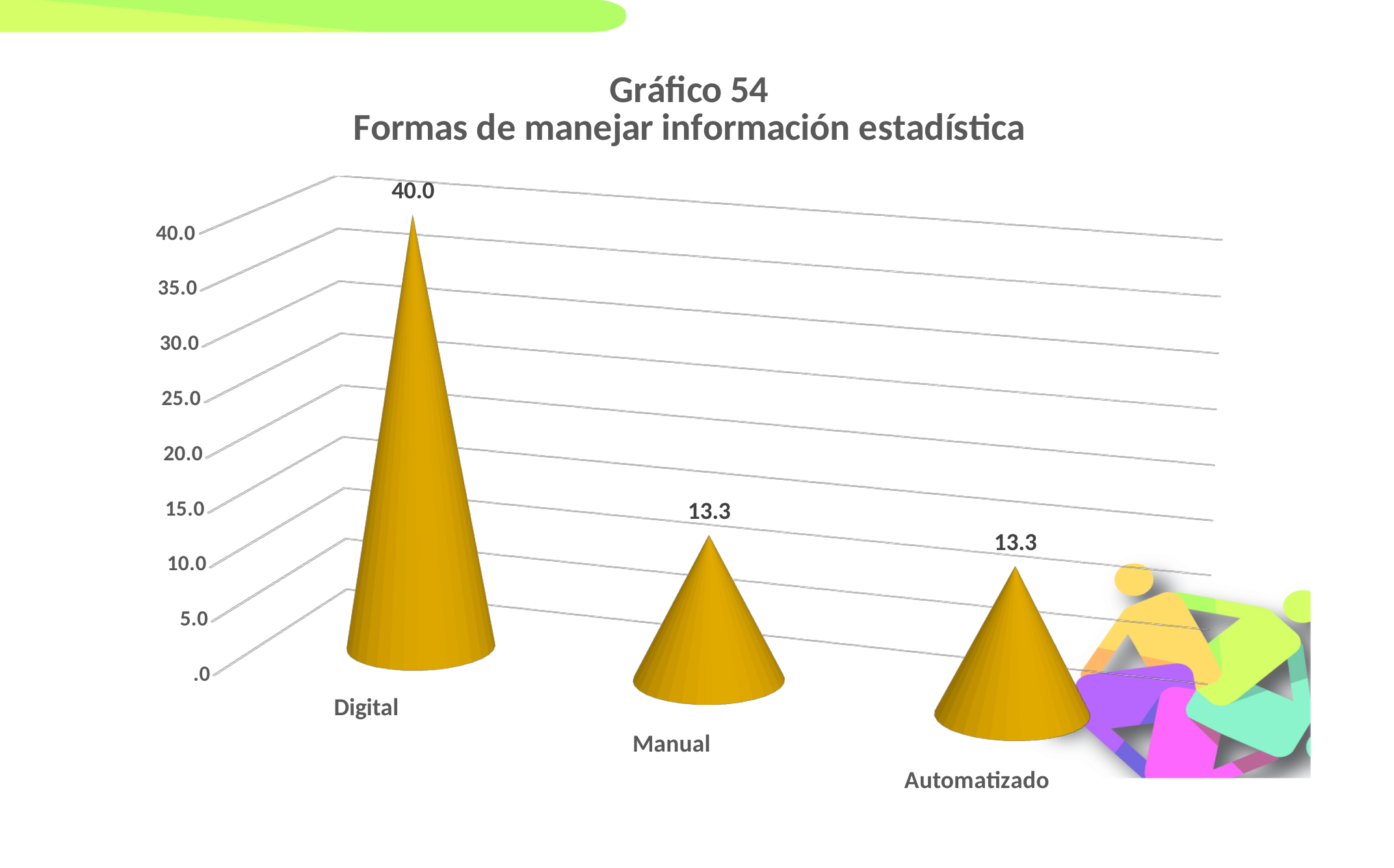
How many categories are shown on the chart? 3 What is the difference between the values for Digital and Manual? 26.7 Is the value for Digital greater or less than 35.0? greater Which category has the highest value? Digital What is the title of the chart? Gráfico 54 Formas de manejar información estadística Which is larger, the value for Digital or the value for Automatizado? Digital What kind of chart is shown on the slide? bar chart What is the value for Digital? 40.0 What is the value for Automatizado? 13.3 Is the value for Manual greater or less than 20.0? less What is the value for Manual? 13.3 What is the highest value shown on the vertical axis? 40.0